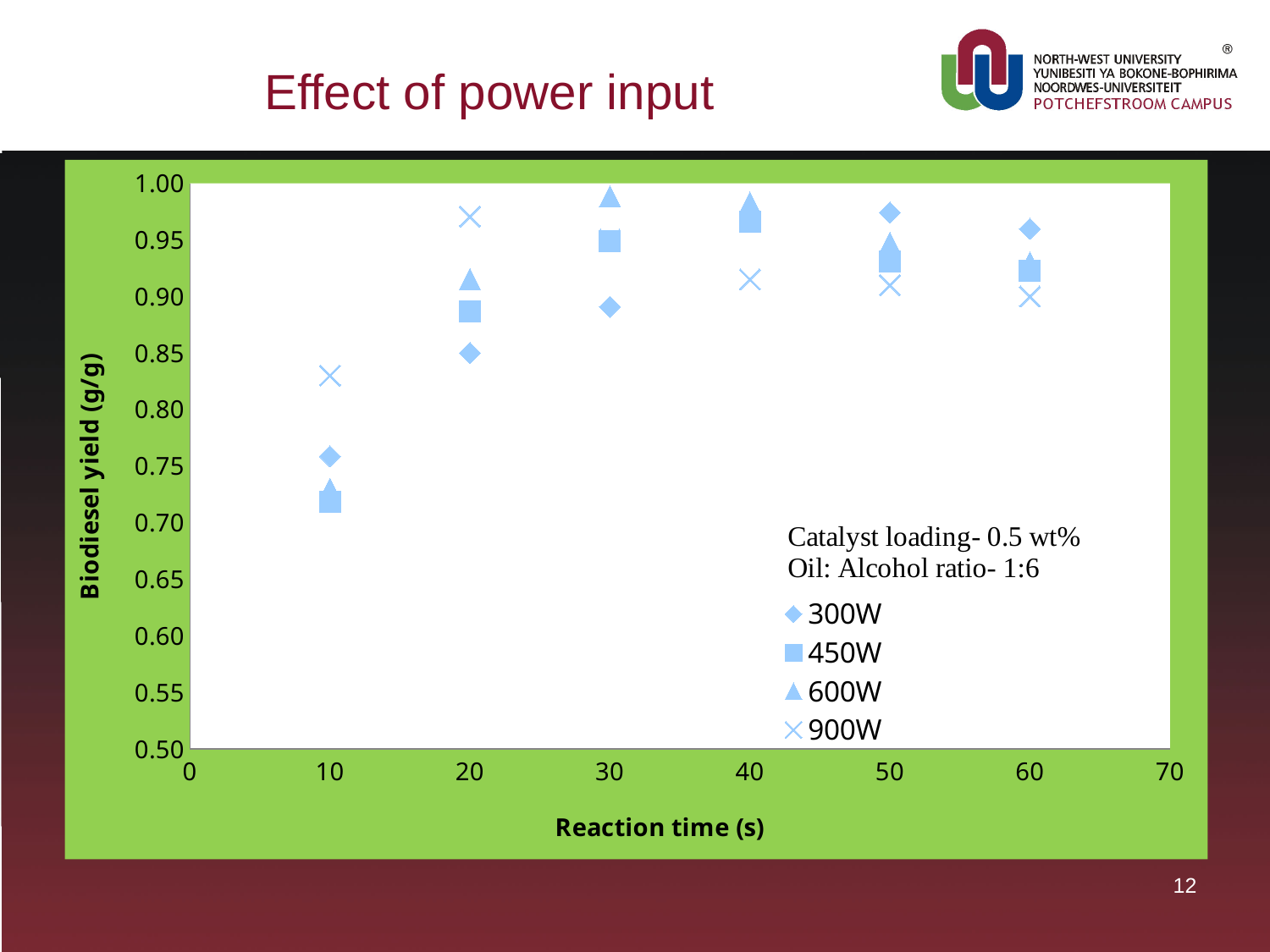
How many series does the legend list? 4 Is the biodiesel yield for 900W at 10 s greater or less than 0.80? greater How many reaction time points are plotted for the 300W series? 6 Is the biodiesel yield for 900W at 60 s greater or less than 0.95? less What is the title of the chart? Effect of power input Which series has the highest biodiesel yield at 10 s? 900W Which series has the lowest biodiesel yield at 60 s? 900W What is the label of the y axis? Biodiesel yield (g/g) What kind of chart is shown on the slide? scatter chart Does the biodiesel yield for 900W rise or fall from 20 s to 60 s? fall Is the biodiesel yield for 300W at 10 s greater or less than 0.80? less